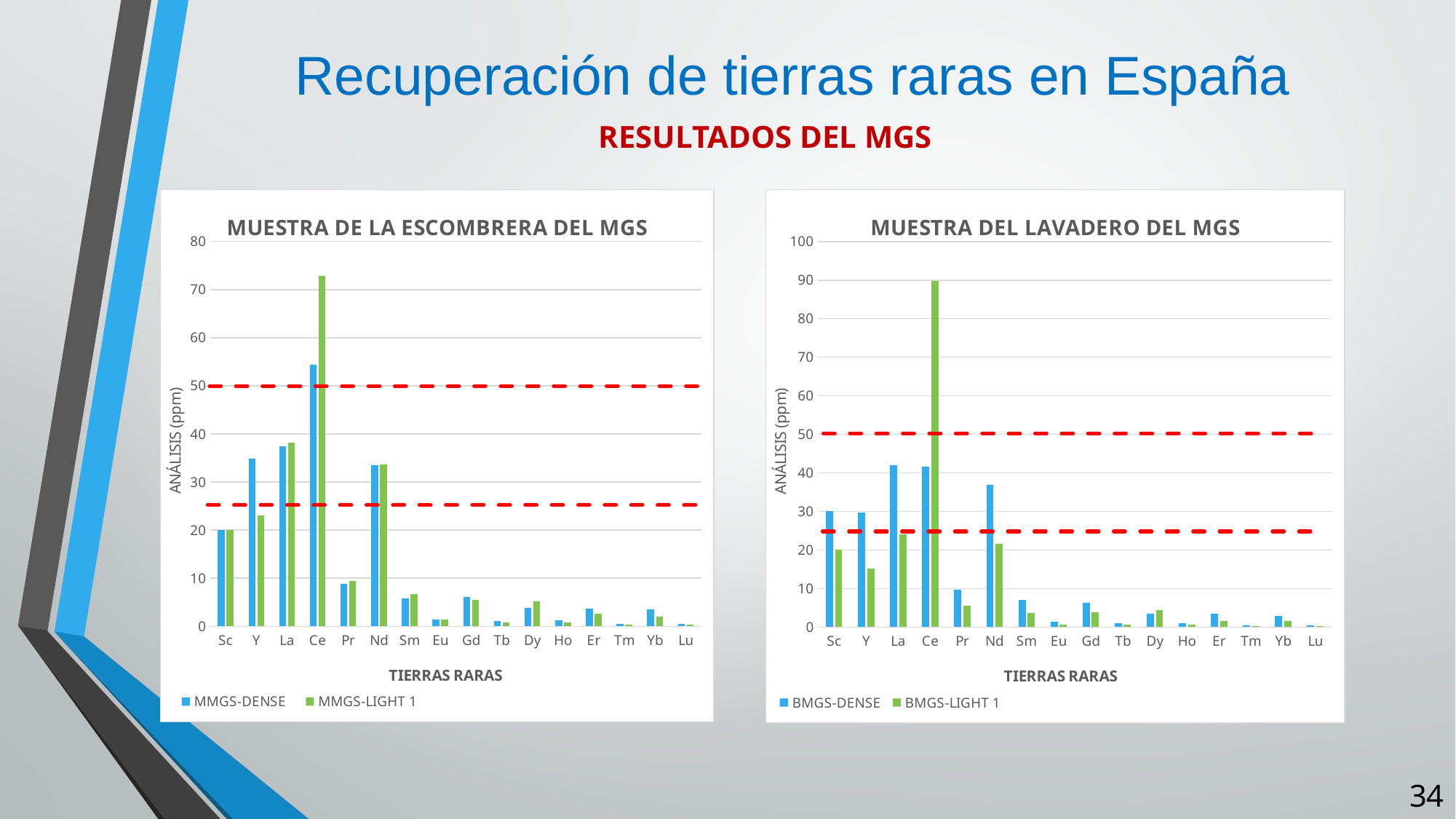
In the chart "MUESTRA DE LA ESCOMBRERA DEL MGS", how many series does the legend list? 2 In the chart "MUESTRA DE LA ESCOMBRERA DEL MGS", which category has the highest MMGS-LIGHT 1 value? Ce In the chart "MUESTRA DE LA ESCOMBRERA DEL MGS", is the MMGS-DENSE value for Ce greater or less than 50? greater In the chart "MUESTRA DE LA ESCOMBRERA DEL MGS", how many rare earth categories are shown on the x axis? 16 In the chart "MUESTRA DEL LAVADERO DEL MGS", is the BMGS-DENSE value for Nd greater or less than 30? greater In the chart "MUESTRA DEL LAVADERO DEL MGS", which is larger for La: BMGS-DENSE or BMGS-LIGHT 1? BMGS-DENSE What kind of chart is "MUESTRA DE LA ESCOMBRERA DEL MGS"? Bar chart In the chart "MUESTRA DE LA ESCOMBRERA DEL MGS", is the MMGS-LIGHT 1 value for Ce greater or less than 70? greater In the chart "MUESTRA DEL LAVADERO DEL MGS", what is the title of the y axis? ANÁLISIS (ppm) In the chart "MUESTRA DE LA ESCOMBRERA DEL MGS", which is larger for Y: MMGS-DENSE or MMGS-LIGHT 1? MMGS-DENSE In the chart "MUESTRA DEL LAVADERO DEL MGS", which category has the highest BMGS-LIGHT 1 value? Ce